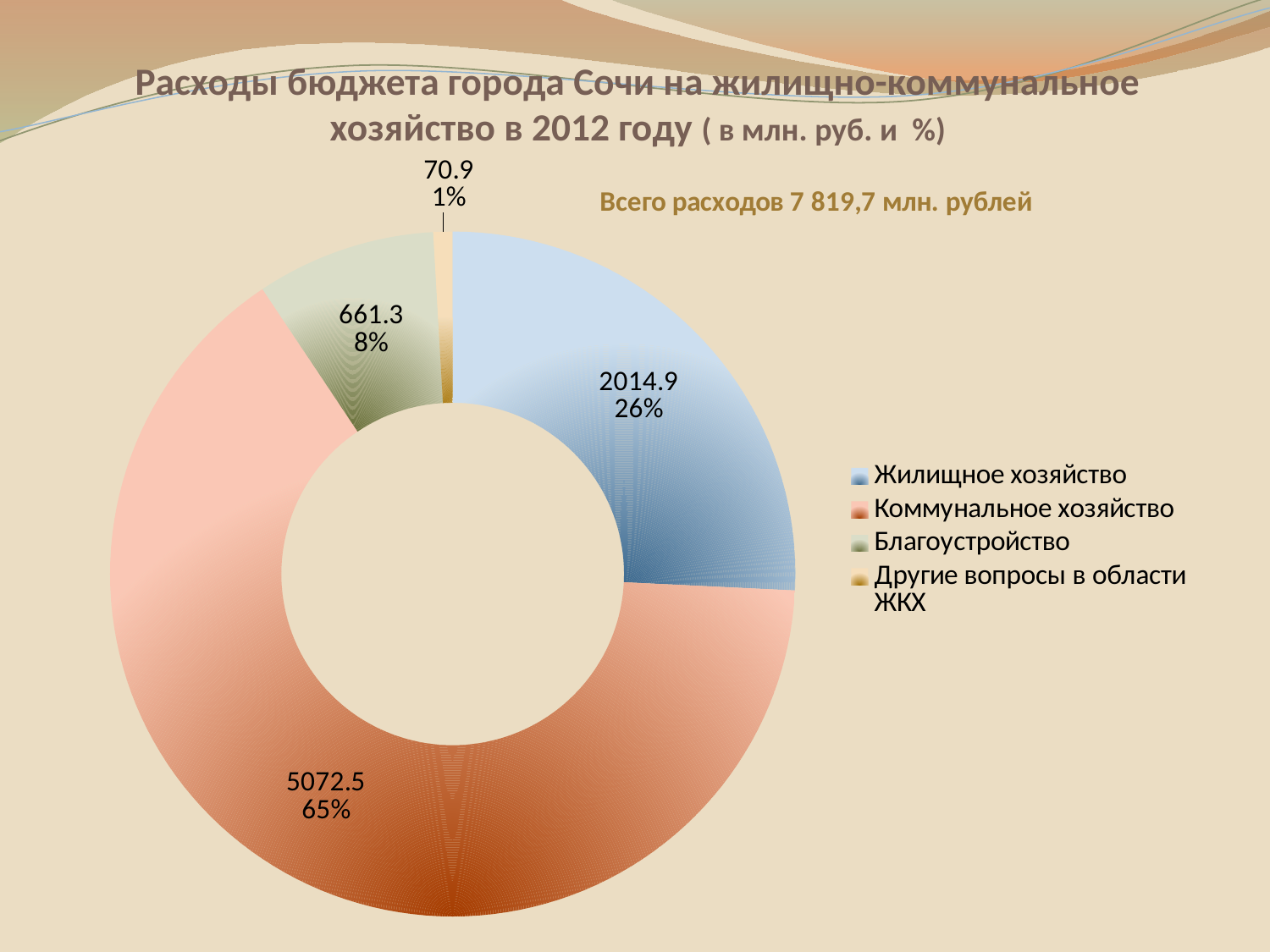
What share of the chart does Благоустройство represent? 8% What is the value for Жилищное хозяйство? 2014.9 Which category has the smallest share of the chart? Другие вопросы в области ЖКХ How many categories does the legend list? 4 What share of the chart does Жилищное хозяйство represent? 26% What is the value for Благоустройство? 661.3 What kind of chart is shown on the slide? Doughnut (pie) chart Which category has the largest share of the chart? Коммунальное хозяйство What is the difference between the values for Коммунальное хозяйство and Жилищное хозяйство? 3057.6 What is the value for Коммунальное хозяйство? 5072.5 What is the value for Другие вопросы в области ЖКХ? 70.9 Which is larger, the value for Благоустройство or the value for Другие вопросы в области ЖКХ? Благоустройство